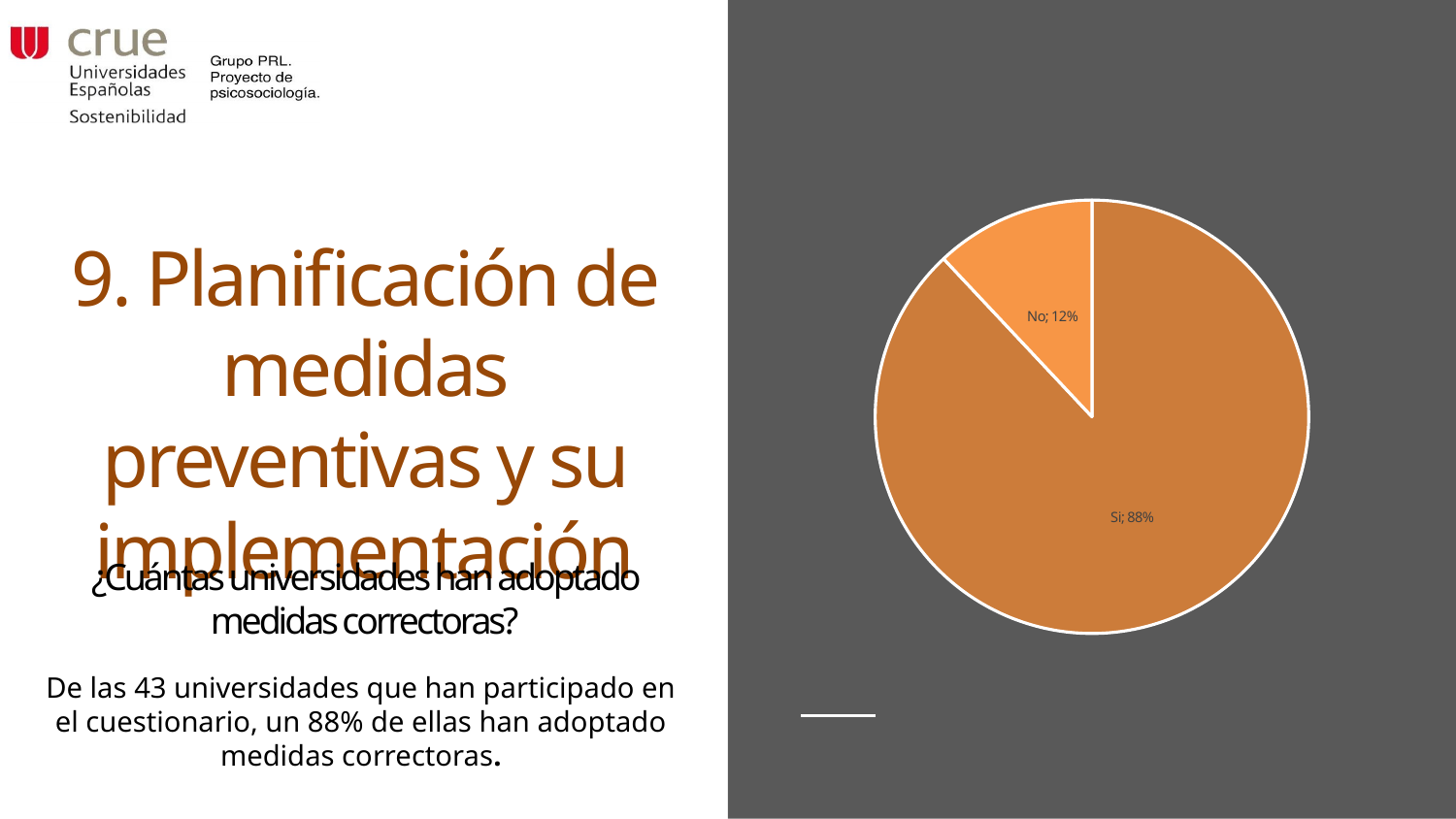
What is the background colour of the area containing the pie chart? dark grey What percentage of the pie chart is labelled 'Si'? 88% Which slice of the pie chart is the smallest? No How many slices does the pie chart have? 2 What percentage of the pie chart is labelled 'No'? 12% Which slice is larger, 'Si' or 'No'? Si What is the difference in percentage points between the 'Si' and 'No' slices? 76 What kind of chart is shown on the slide? pie chart Which slice of the pie chart is the largest? Si What share of the pie does the 'No' slice represent? 12% Is the value for 'Si' greater or less than 50%? greater